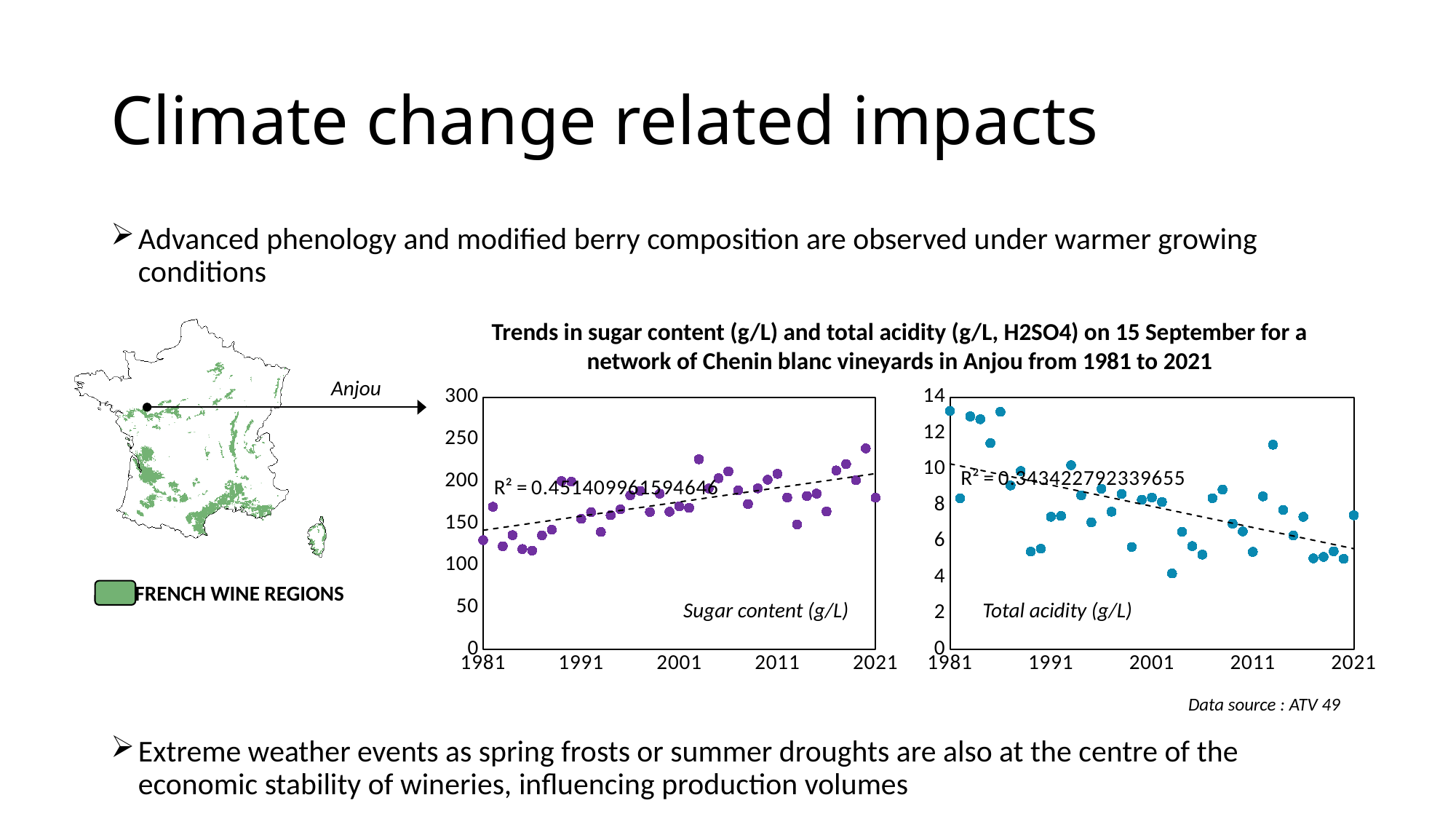
Which chart has the higher R² value, Sugar content (g/L) or Total acidity (g/L)? Sugar content (g/L) What R² value is shown on the Total acidity (g/L) chart? 0.343422792339655 In the Total acidity (g/L) chart, do the values generally rise or fall from 1981 to 2021? fall What kind of chart is the Total acidity (g/L) chart? scatter chart In the Total acidity (g/L) chart, is the value for 1981 greater or less than 12? greater In the Sugar content (g/L) chart, do the values generally rise or fall from 1981 to 2021? rise In the Sugar content (g/L) chart, is the value for 1981 greater or less than 150? less What kind of chart is the Sugar content (g/L) chart? scatter chart In the Total acidity (g/L) chart, is the value for 2021 greater or less than 8? less What R² value is shown on the Sugar content (g/L) chart? 0.451409961594646 What is the first year shown on the x axis of the Sugar content (g/L) chart? 1981